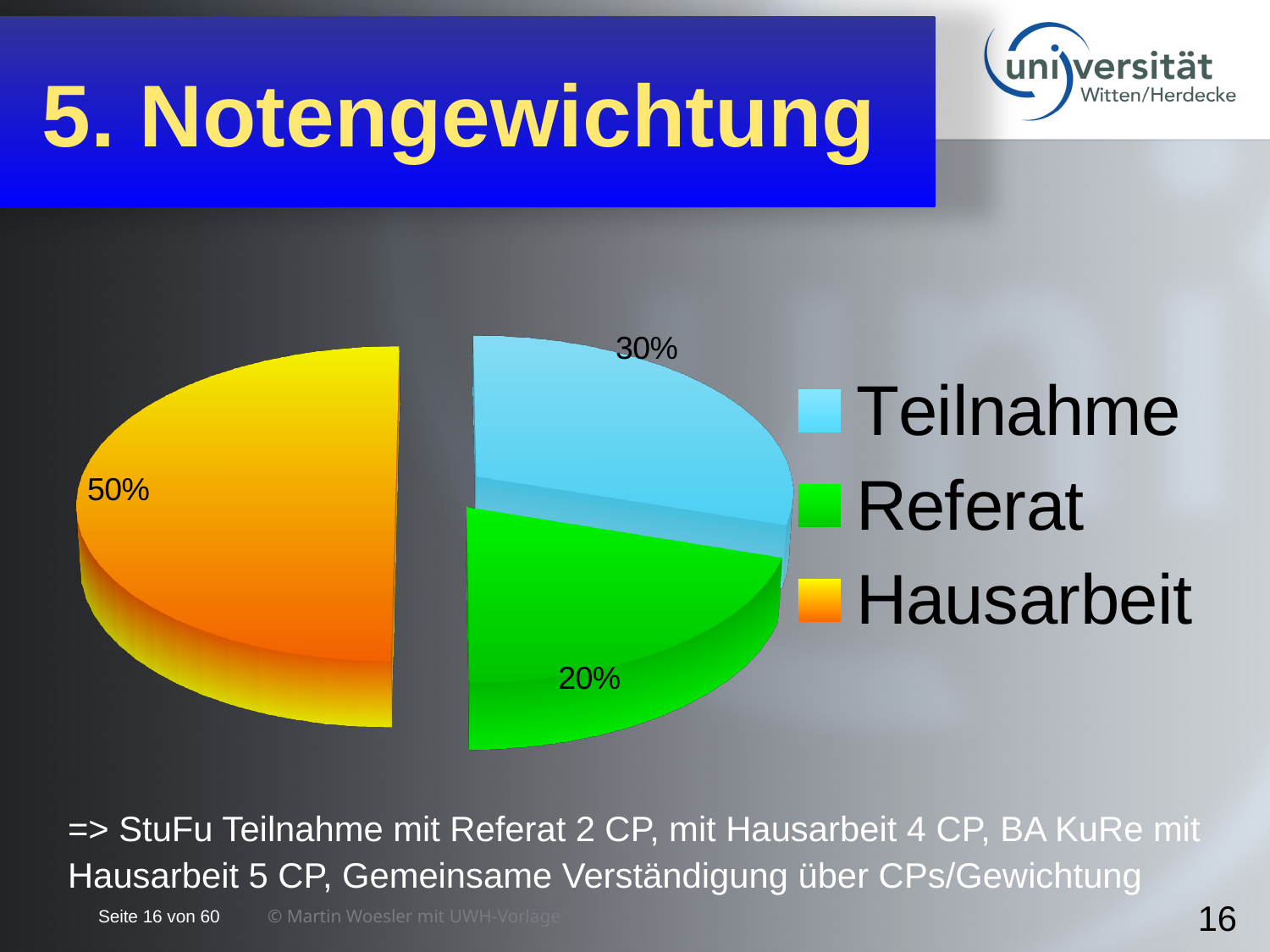
What share of the pie does Referat have? 20% What kind of chart is shown on the slide? pie chart Which category has the largest slice of the pie? Hausarbeit What is the difference in percentage points between Teilnahme and Referat? 10 How many slices does the pie chart have? 3 What colour is the Referat slice in the pie chart? green How many entries does the legend list? 3 What is the difference in percentage points between Hausarbeit and Referat? 30 Which category has the smallest slice of the pie? Referat What share of the pie does Hausarbeit have? 50% Which is larger, the share for Teilnahme or the share for Referat? Teilnahme What share of the pie does Teilnahme have? 30%